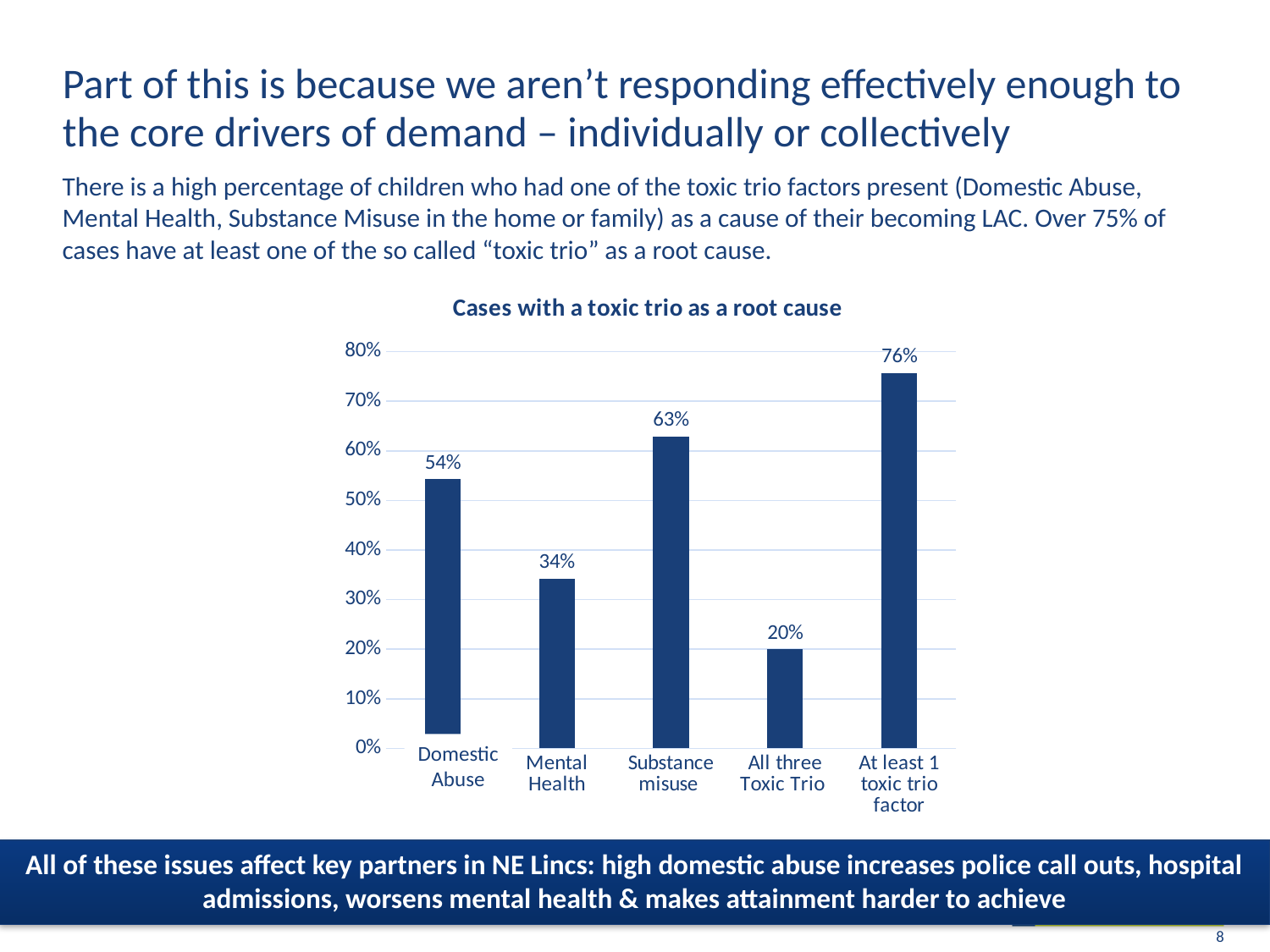
What is the value for Substance misuse? 63% Is the value for Substance misuse greater or less than 60%? greater What is the value for Domestic Abuse? 54% Which is larger, the value for Mental Health or the value for All three Toxic Trio? Mental Health What is the title of the chart? Cases with a toxic trio as a root cause How many categories are shown on the x axis? 5 Which category has the lowest value? All three Toxic Trio What is the difference between the values for Substance misuse and Domestic Abuse? 9% What kind of chart is shown on the slide? bar chart What is the value for Mental Health? 34% What is the value for All three Toxic Trio? 20% Which category has the highest value? At least 1 toxic trio factor